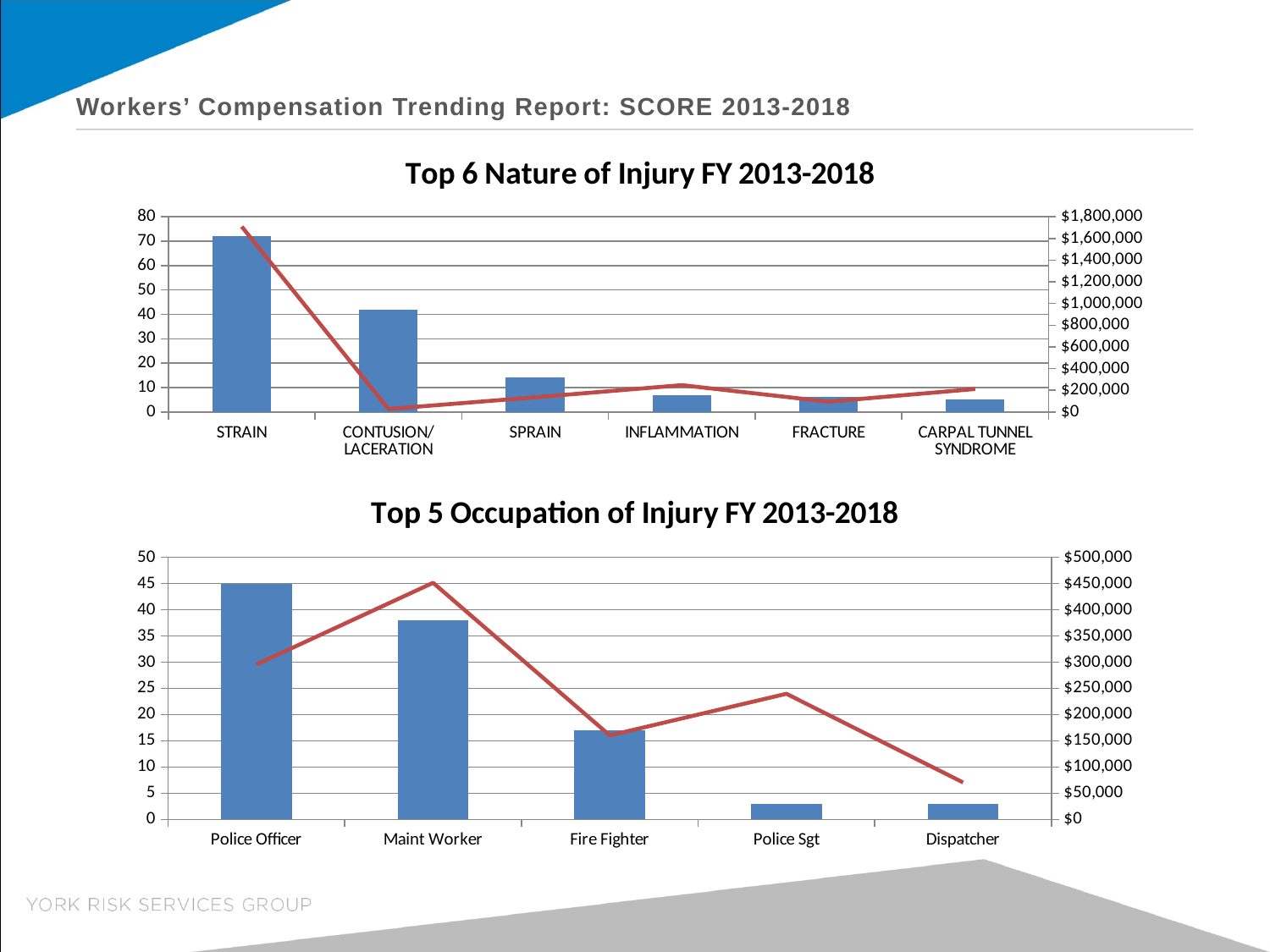
In the 'Top 5 Occupation of Injury FY 2013-2018' chart, which occupation does the red line peak at? Maint Worker In the 'Top 6 Nature of Injury FY 2013-2018' chart, how many nature-of-injury categories are shown on the x axis? 6 In the 'Top 6 Nature of Injury FY 2013-2018' chart, what kind of chart is used for the injury counts? bar chart In the 'Top 6 Nature of Injury FY 2013-2018' chart, is the bar for STRAIN greater or less than 70? greater In the 'Top 5 Occupation of Injury FY 2013-2018' chart, which occupation has the tallest bar? Police Officer In the 'Top 5 Occupation of Injury FY 2013-2018' chart, how many occupations are shown on the x axis? 5 In the 'Top 5 Occupation of Injury FY 2013-2018' chart, is the bar for Fire Fighter greater or less than 20? less In the 'Top 6 Nature of Injury FY 2013-2018' chart, which category has the tallest bar? STRAIN In the 'Top 6 Nature of Injury FY 2013-2018' chart, which has the taller bar, SPRAIN or INFLAMMATION? SPRAIN In the 'Top 5 Occupation of Injury FY 2013-2018' chart, is the bar for Maint Worker greater or less than 35? greater In the 'Top 6 Nature of Injury FY 2013-2018' chart, does the red line rise or fall from STRAIN to CONTUSION/LACERATION? fall